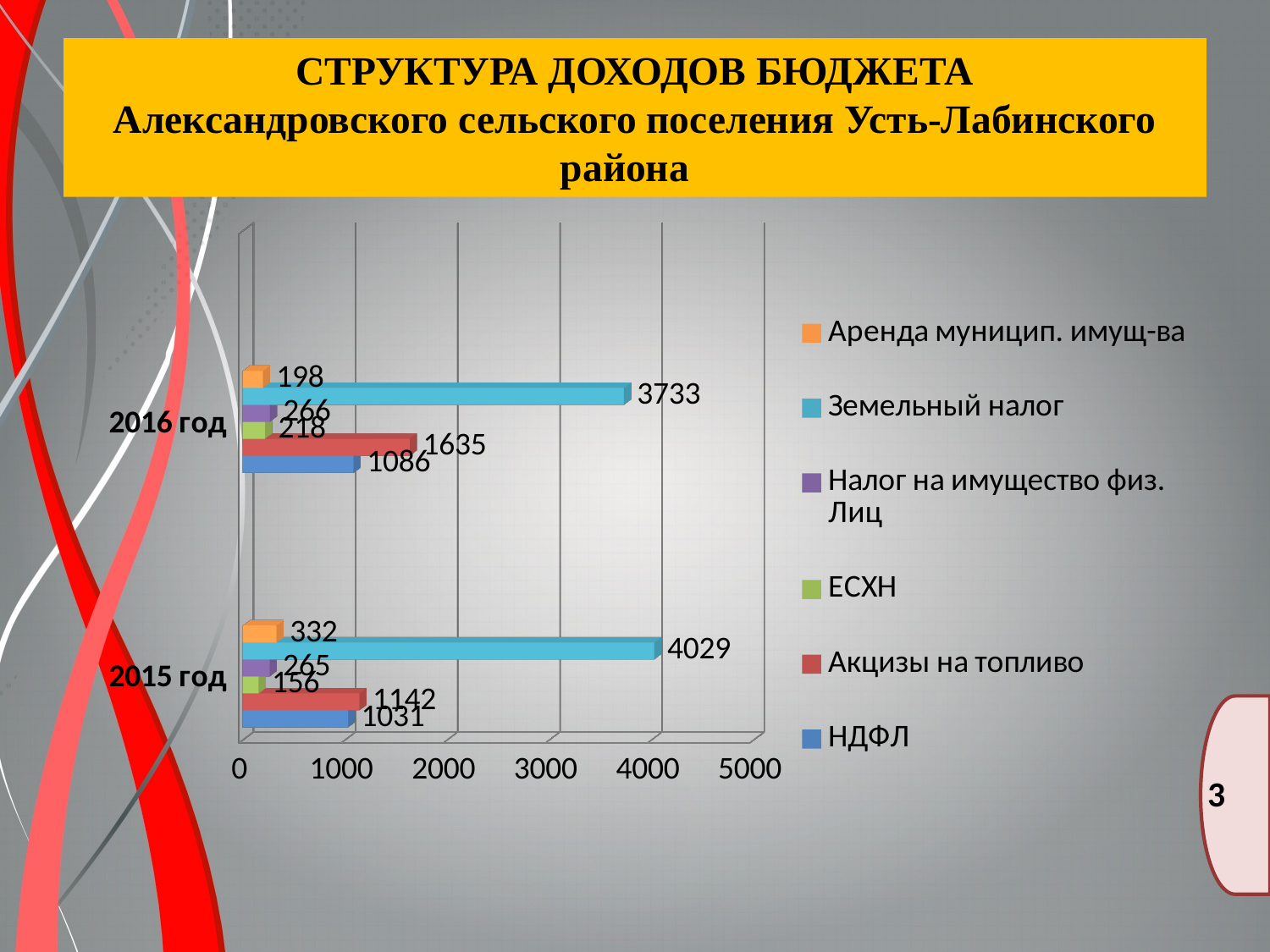
How many year categories are shown on the chart? 2 What is the value of Земельный налог for 2016 год? 3733 What kind of chart is shown on the slide? bar chart Is the value of Земельный налог for 2015 год greater or less than 4000? greater Which series has the lowest value for 2016 год? Аренда муницип. имущ-ва What is the value of НДФЛ for 2015 год? 1031 Which series has the highest value for 2015 год? Земельный налог How many series does the legend list? 6 Which is larger: Акцизы на топливо in 2016 год or in 2015 год? 2016 год What is the difference between Земельный налог in 2015 год and in 2016 год? 296 What is the value of Аренда муницип. имущ-ва for 2015 год? 332 What is the value of Акцизы на топливо for 2016 год? 1635